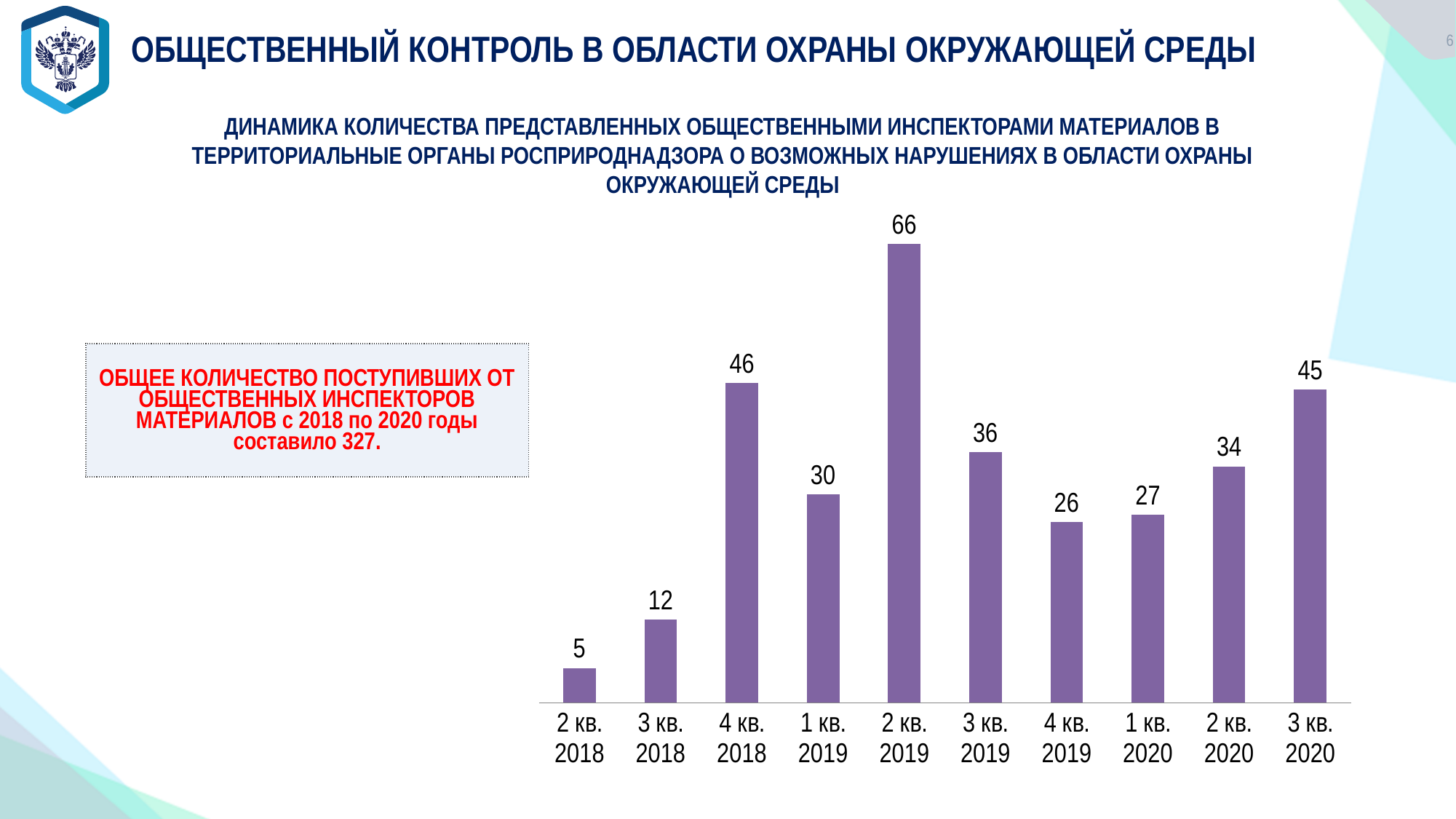
How many quarters are shown on the x axis? 10 What total number of materials received from public inspectors for 2018–2020 is stated in the text box on the slide? 327 What is the value for 2 кв. 2019? 66 Which is larger, the value for 4 кв. 2018 or the value for 3 кв. 2020? 4 кв. 2018 What is the difference between the values for 3 кв. 2020 and 2 кв. 2020? 11 Which quarter has the highest value? 2 кв. 2019 Do the values rise or fall from 2 кв. 2018 to 4 кв. 2018? Rise What is the difference between the values for 2 кв. 2019 and 3 кв. 2019? 30 Which quarter has the lowest value? 2 кв. 2018 What is the value for 4 кв. 2018? 46 What kind of chart is shown on the slide? Bar chart What is the value for 1 кв. 2020? 27